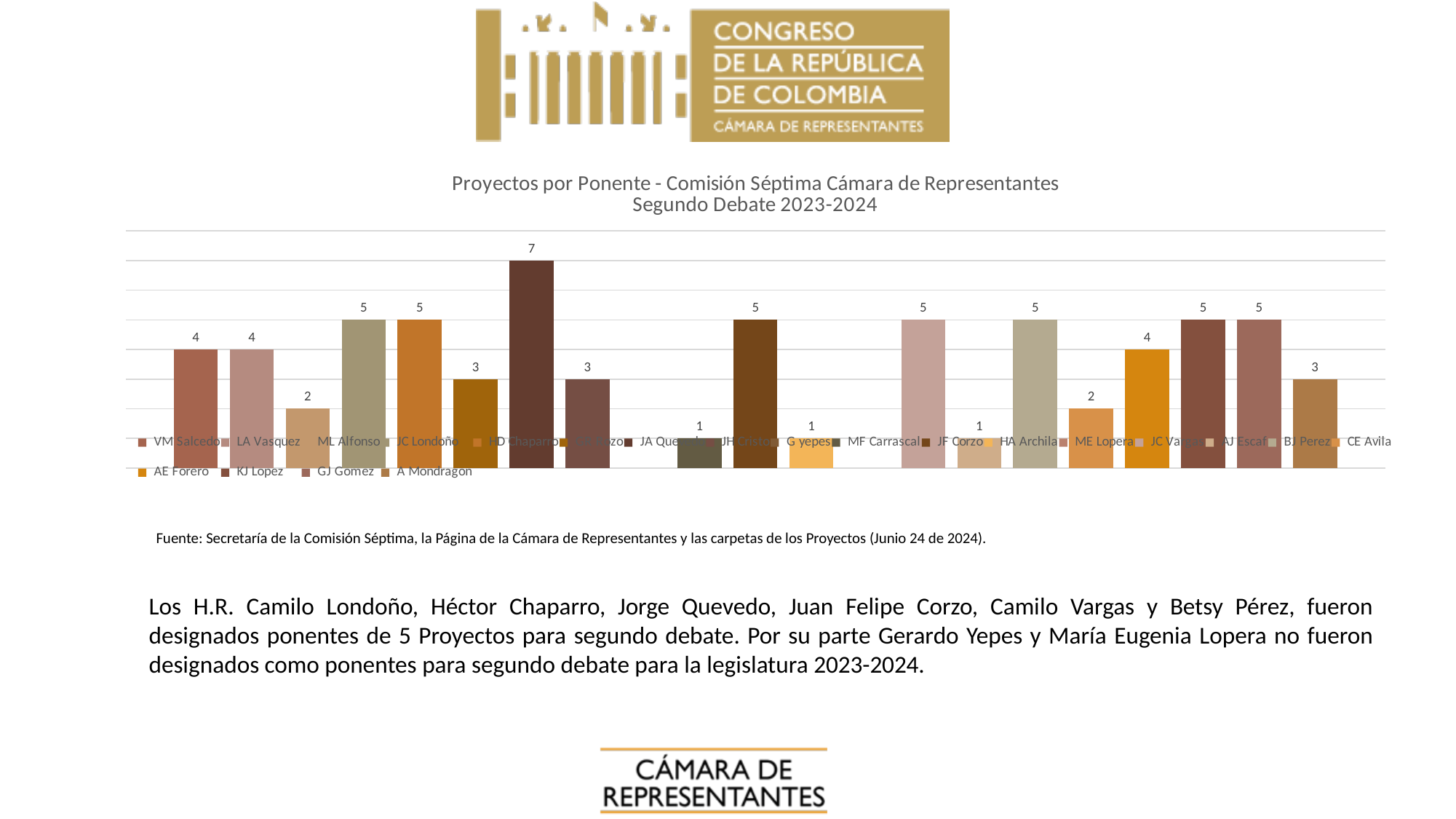
What is the value of the leftmost bar in the chart? 4 What is the lowest value printed on a bar in the chart? 1 How many bars in the chart are labeled with the value 1? 3 How many bars in the chart are labeled with the value 7? 1 Which entry appears first in the chart legend? VM Salcedo What type of chart is shown on the slide? bar chart What is the value of the rightmost bar in the chart? 3 What is the difference between the tallest bar (7) and the shortest labeled bar (1)? 6 How many entries does the chart legend list? 21 What is the highest value shown by any bar in the chart? 7 What is the title of the chart? Proyectos por Ponente - Comisión Séptima Cámara de Representantes Segundo Debate 2023-2024 Is the tallest bar in the chart greater or less than 6? greater